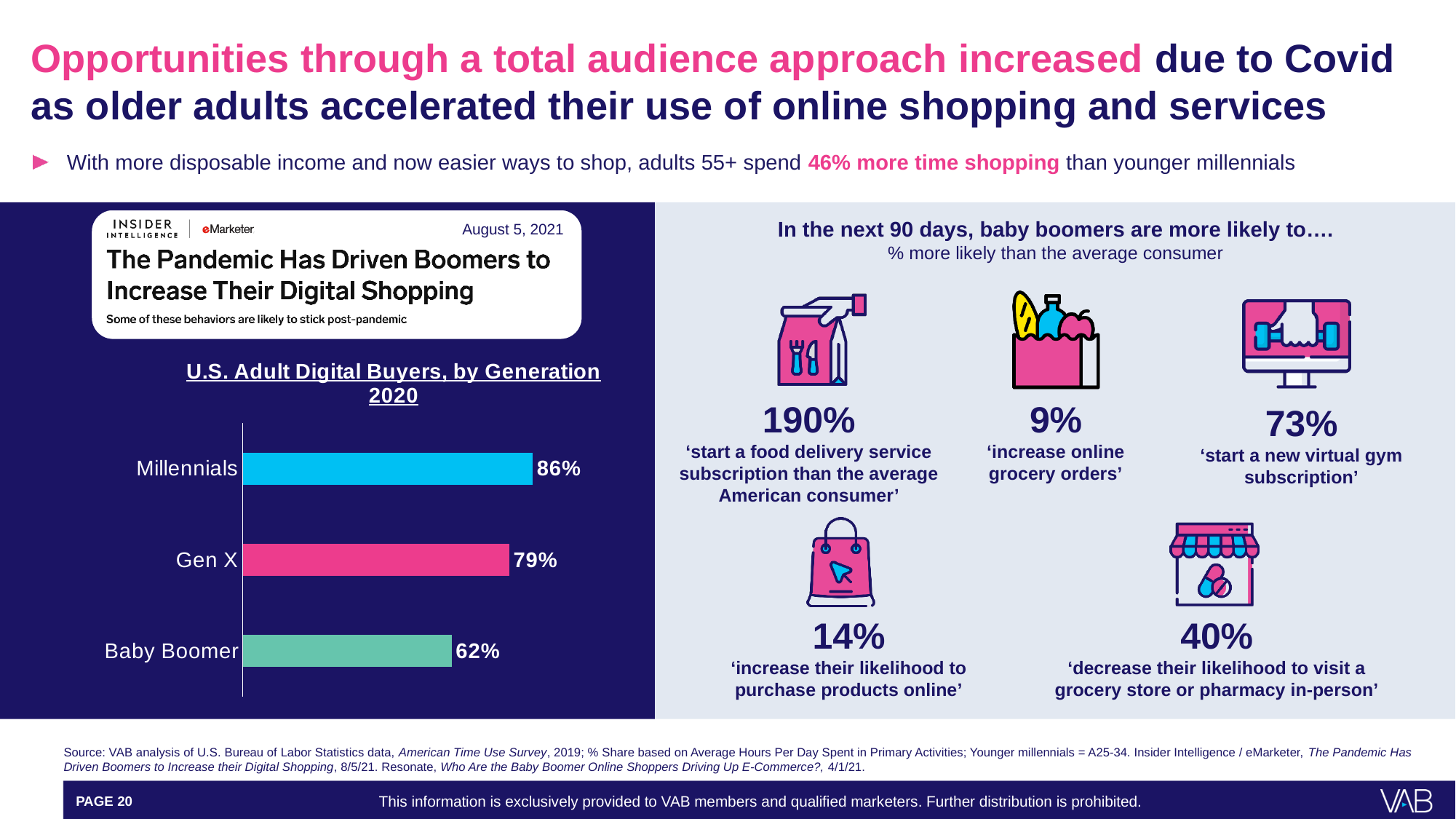
In the U.S. Adult Digital Buyers, by Generation 2020 chart, which is larger: the value for Gen X or the value for Baby Boomer? Gen X What is the difference between the Gen X and Baby Boomer values in the U.S. Adult Digital Buyers, by Generation 2020 chart? 17% Which generation has the lowest share of digital buyers in the U.S. Adult Digital Buyers, by Generation 2020 chart? Baby Boomer How many generations are shown in the U.S. Adult Digital Buyers, by Generation 2020 chart? 3 What colour is the Baby Boomer bar in the U.S. Adult Digital Buyers, by Generation 2020 chart? Green What is the value for Baby Boomer in the U.S. Adult Digital Buyers, by Generation 2020 chart? 62% What is the value for Gen X in the U.S. Adult Digital Buyers, by Generation 2020 chart? 79% What is the difference between the Millennials and Baby Boomer values in the U.S. Adult Digital Buyers, by Generation 2020 chart? 24% What is the value for Millennials in the U.S. Adult Digital Buyers, by Generation 2020 chart? 86% Do the values in the U.S. Adult Digital Buyers, by Generation 2020 chart rise or fall going from Millennials down to Baby Boomer? Fall Which generation has the highest share of digital buyers in the U.S. Adult Digital Buyers, by Generation 2020 chart? Millennials What type of chart is the U.S. Adult Digital Buyers, by Generation 2020 chart? Bar chart